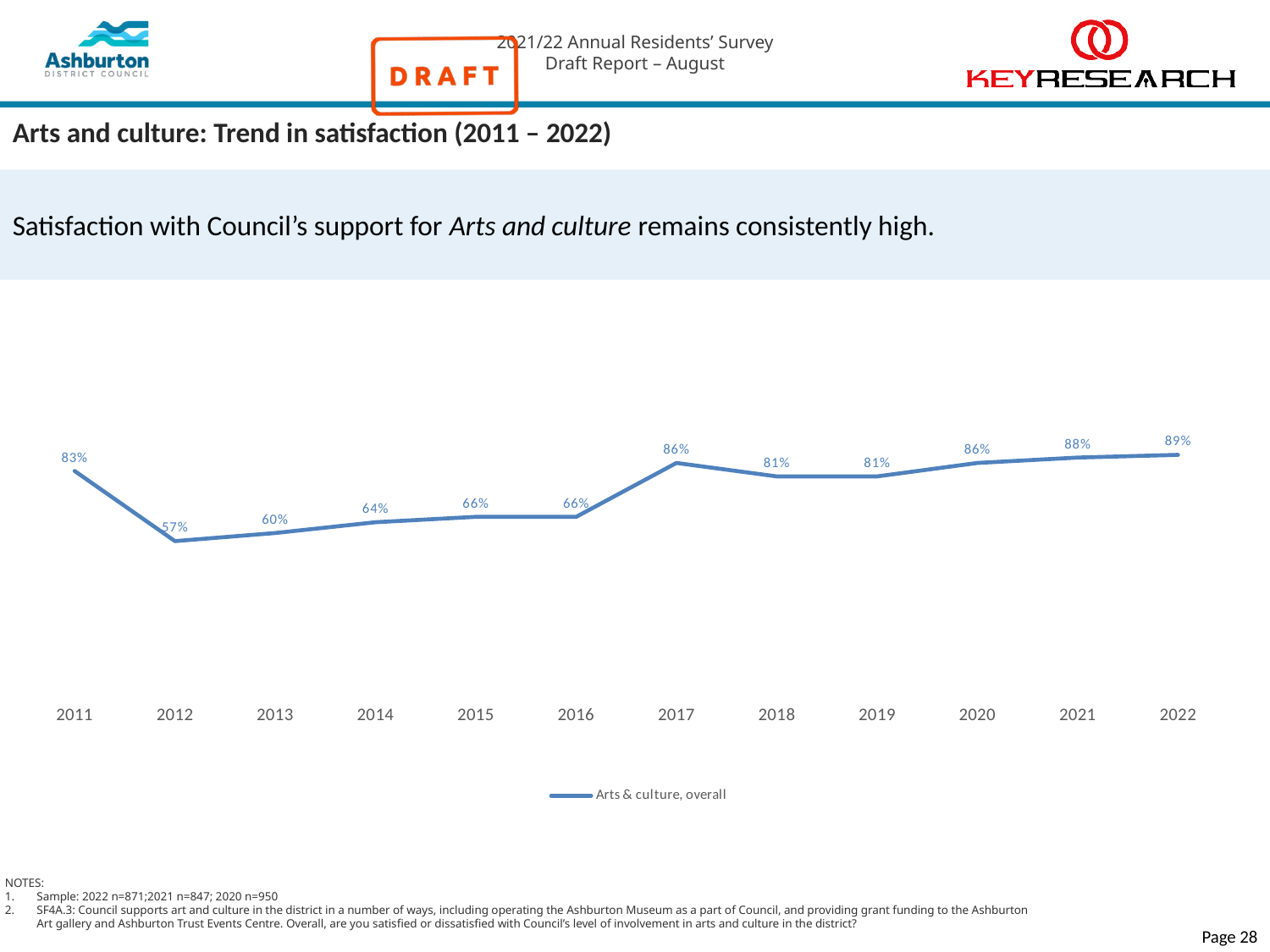
Which year has the lowest satisfaction value? 2012 Which year has the highest satisfaction value? 2022 What is the satisfaction value for 2017? 86% Which is larger, the value for 2011 or the value for 2016? 2011 What is the satisfaction value for 2022? 89% What is the satisfaction value for 2011? 83% What kind of chart is shown? Line chart What is the legend entry for the plotted series? Arts & culture, overall How many series does the legend list? 1 How many years are plotted on the x axis? 12 Do the values rise or fall from 2016 to 2022? Rise What is the difference between the 2022 value and the 2012 value? 32 percentage points